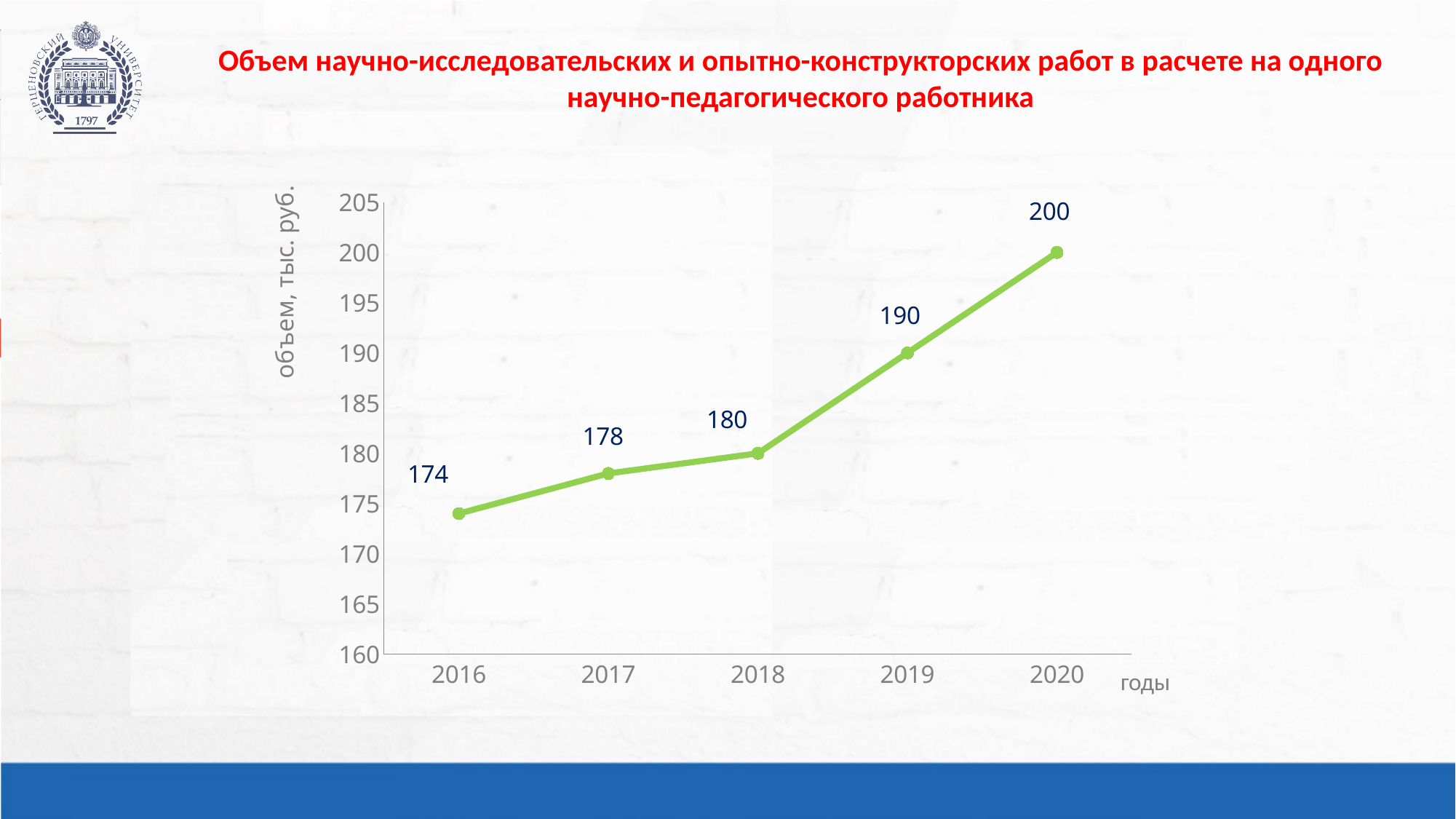
How many years are plotted on the chart? 5 What is the value for 2018? 180 Which year has the lowest value? 2016 Which year has the highest value? 2020 Which is larger, the value for 2017 or the value for 2019? 2019 What is the value for 2016? 174 What is the difference between the values for 2020 and 2019? 10 Is the value for 2019 greater or less than 185? greater Do the values rise or fall from 2016 to 2020? rise What kind of chart is shown on the slide? line chart What is the difference between the values for 2018 and 2016? 6 What is the value for 2020? 200